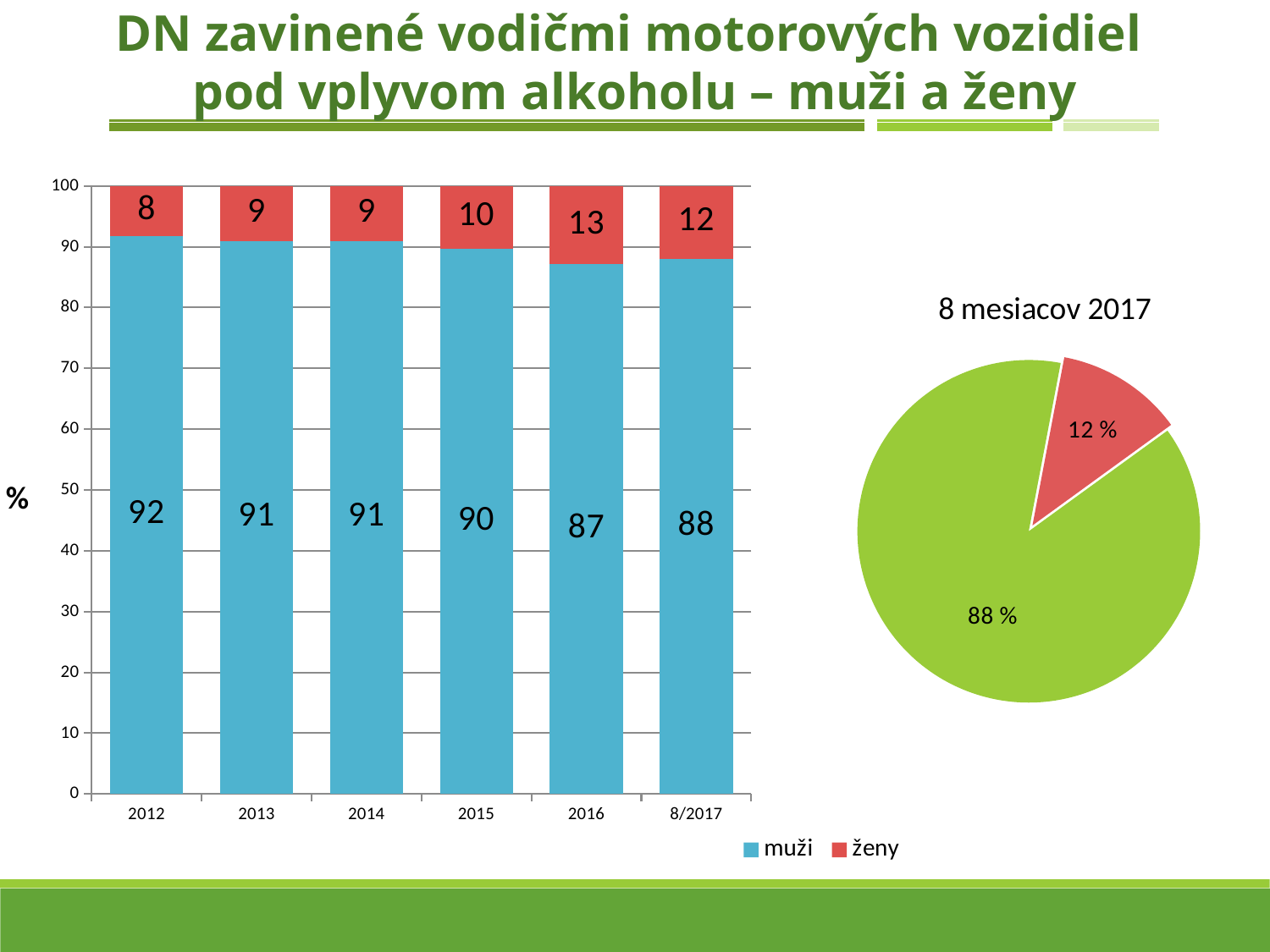
In the stacked bar chart on the left, how many years are shown on the x axis? 6 In the stacked bar chart on the left, what is the value for muži in 2012? 92 In the stacked bar chart on the left, which year has the lowest value for muži? 2016 In the pie chart titled '8 mesiacov 2017', what share does the red slice represent? 12 % In the stacked bar chart on the left, how many series does the legend list? 2 In the stacked bar chart on the left, what is the value for ženy in 8/2017? 12 In the stacked bar chart on the left, what is the difference between the muži value in 2012 and the muži value in 2016? 5 What kind of chart is shown on the right side of the slide? pie chart In the stacked bar chart on the left, which year has the highest value for ženy? 2016 In the stacked bar chart on the left, what is the total of the stacked bar for 2015? 100 In the stacked bar chart on the left, what is the value for ženy in 2016? 13 In the stacked bar chart on the left, is the ženy value larger in 2015 or in 2016? 2016